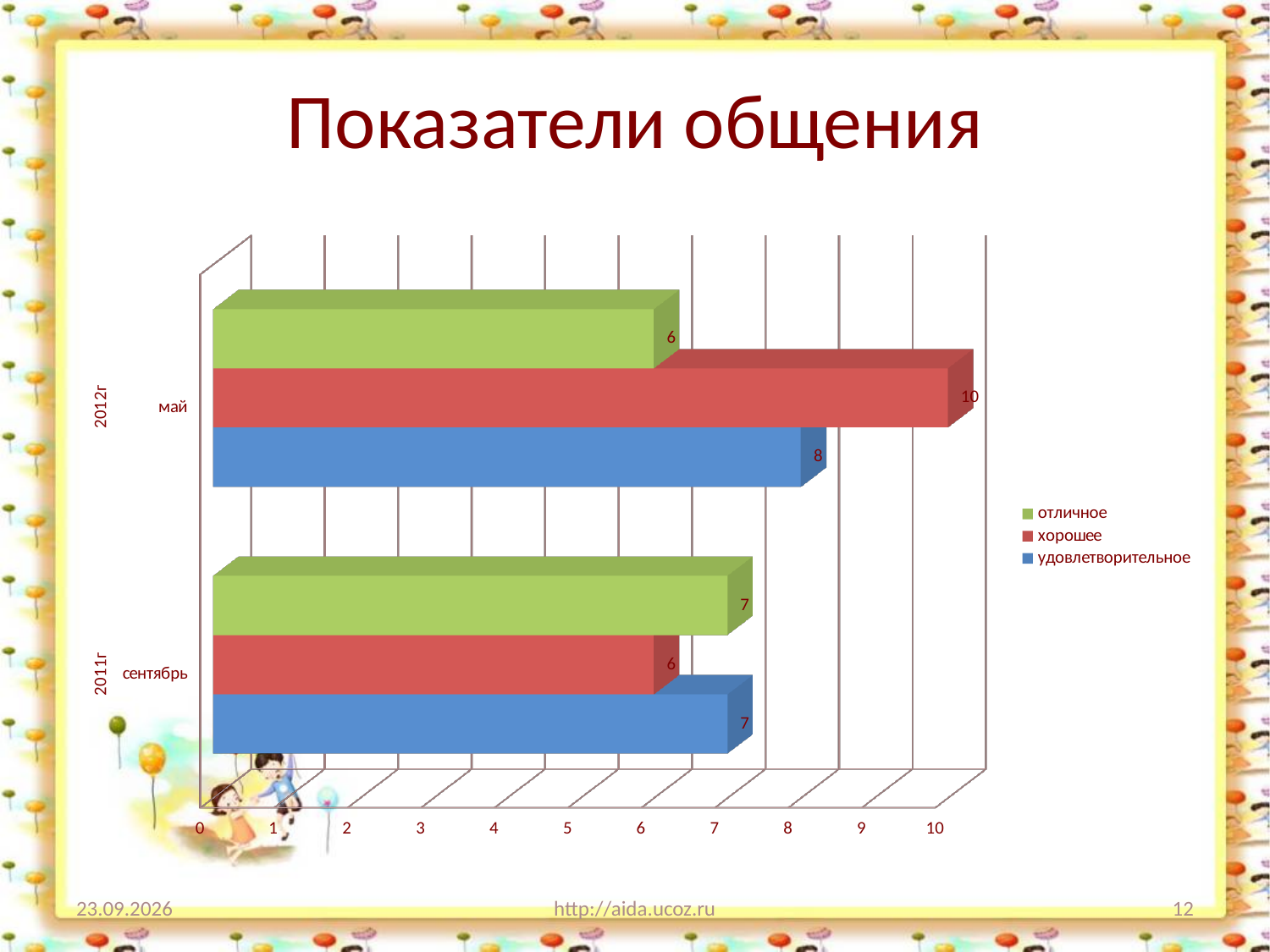
What is the value for отличное in сентябрь (2011г)? 7 What is the value for хорошее in сентябрь (2011г)? 6 How many series does the legend list? 3 How many categories are shown on the vertical axis? 2 Which series has the lowest value in сентябрь (2011г)? хорошее What kind of chart is shown on the slide? bar chart What is the value for хорошее in май (2012г)? 10 What is the title of the chart on the slide? Показатели общения Which is larger: удовлетворительное in май or удовлетворительное in сентябрь? май What is the value for удовлетворительное in май (2012г)? 8 What is the difference between the хорошее values for май and сентябрь? 4 Which series has the highest value in май (2012г)? хорошее